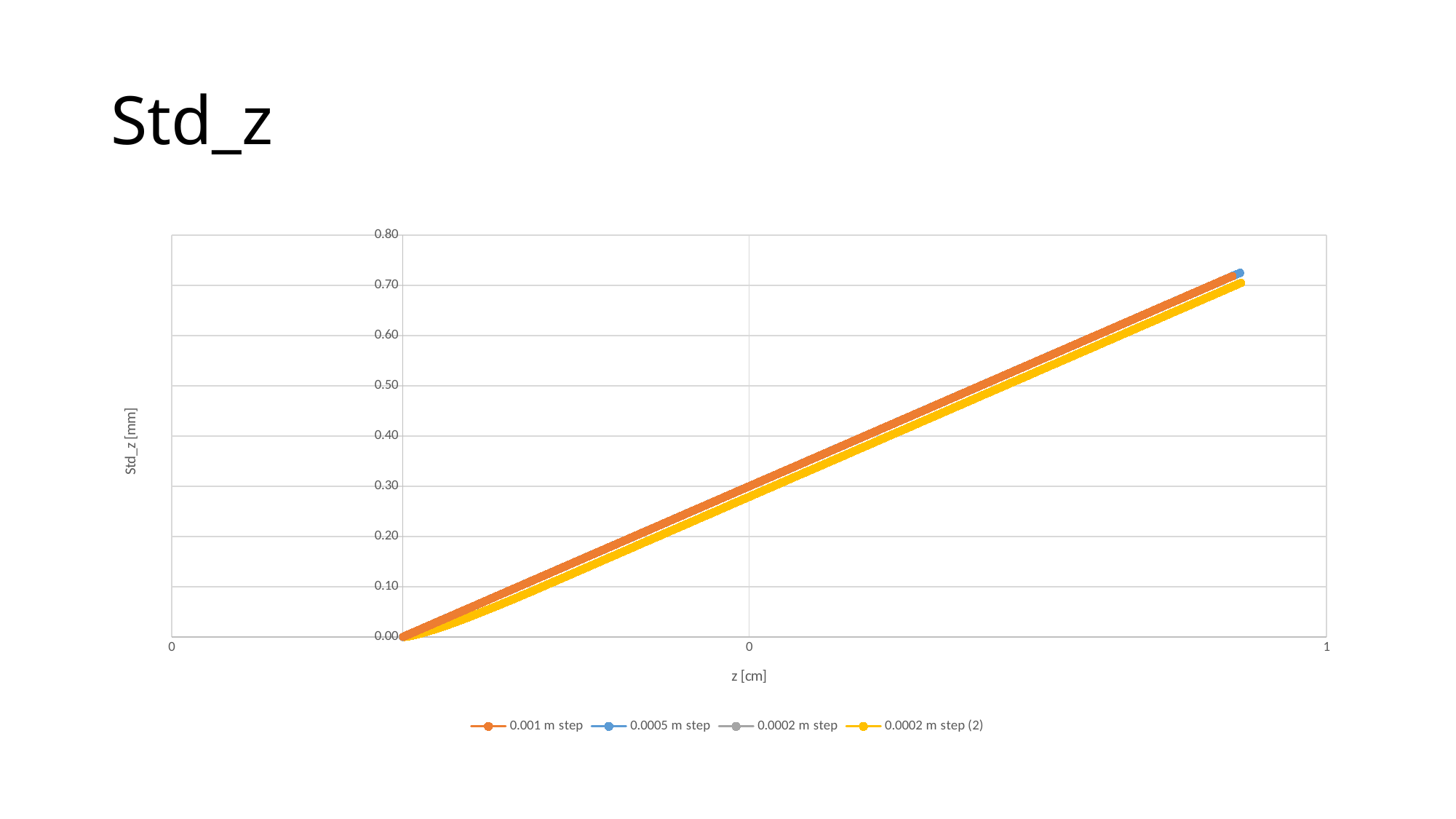
How many series does the legend list? 4 What is the label of the vertical axis? Std_z [mm] What kind of chart is shown on the slide? line chart Do the Std_z values rise or fall as z increases along the x axis? rise Is the highest value reached by the 0.0005 m step series greater or less than 0.60? greater Is the value of the 0.0002 m step (2) series at its left-most point greater or less than 0.10? less Is the highest value reached by the 0.001 m step series greater or less than 0.80? less What are the series names listed in the legend? 0.001 m step, 0.0005 m step, 0.0002 m step, 0.0002 m step (2)